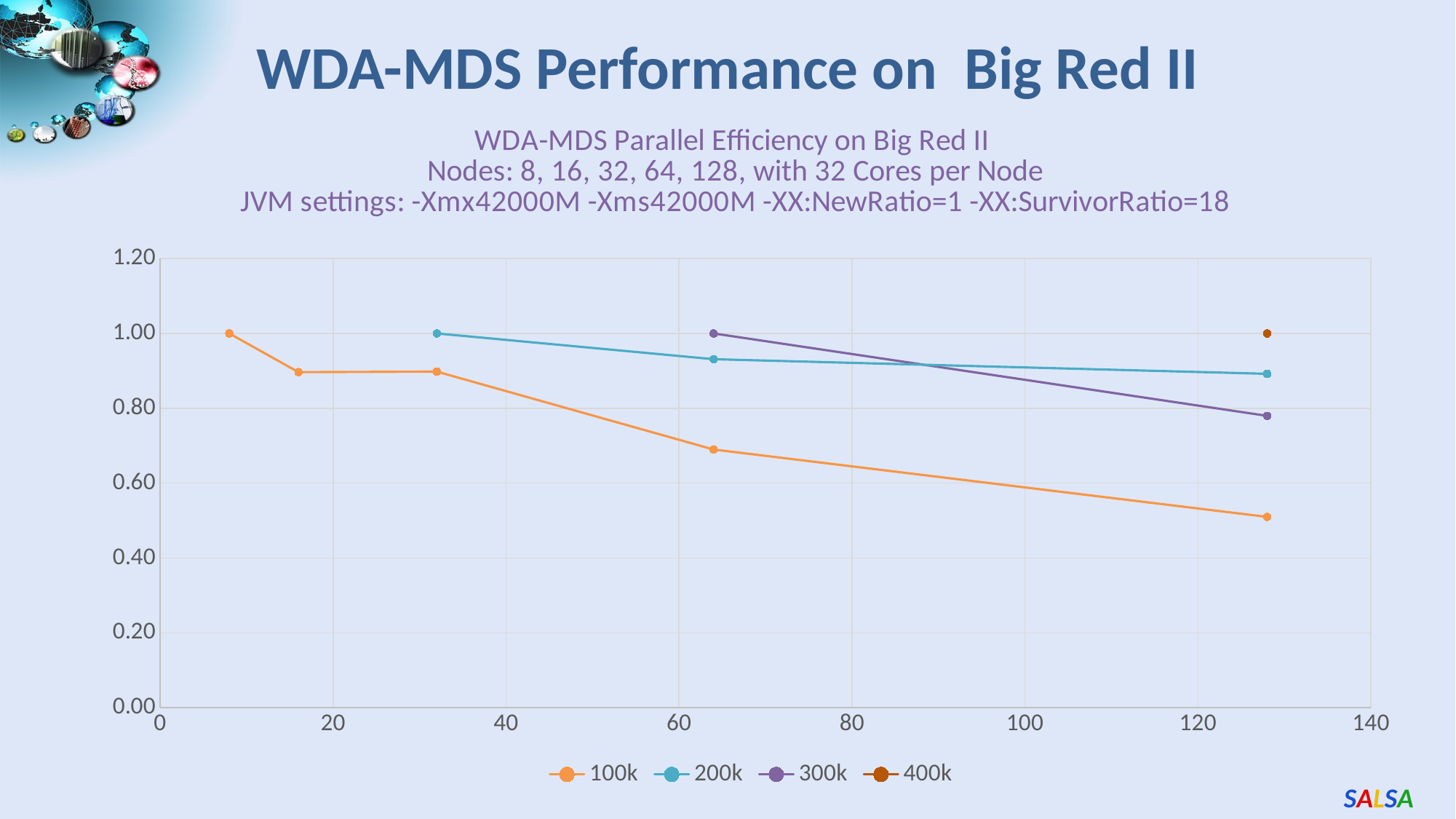
Is the value for the 200k series at 64 nodes greater or less than 0.80? greater What are the series names listed in the legend? 100k, 200k, 300k, 400k How many series does the legend list? 4 Does the 100k series rise or fall as the number of nodes increases? fall At 128 nodes, which series has the higher value, 100k or 200k? 200k Is the value for the 300k series at 128 nodes greater or less than 0.60? greater Is the value for the 100k series at 128 nodes greater or less than 0.60? less What is the parallel efficiency of the 100k series at 8 nodes? 1.00 How many data points are plotted for the 200k series? 3 How many data points are plotted for the 100k series? 5 Which series has the lowest value at 128 nodes? 100k What kind of chart is shown on the slide? line chart